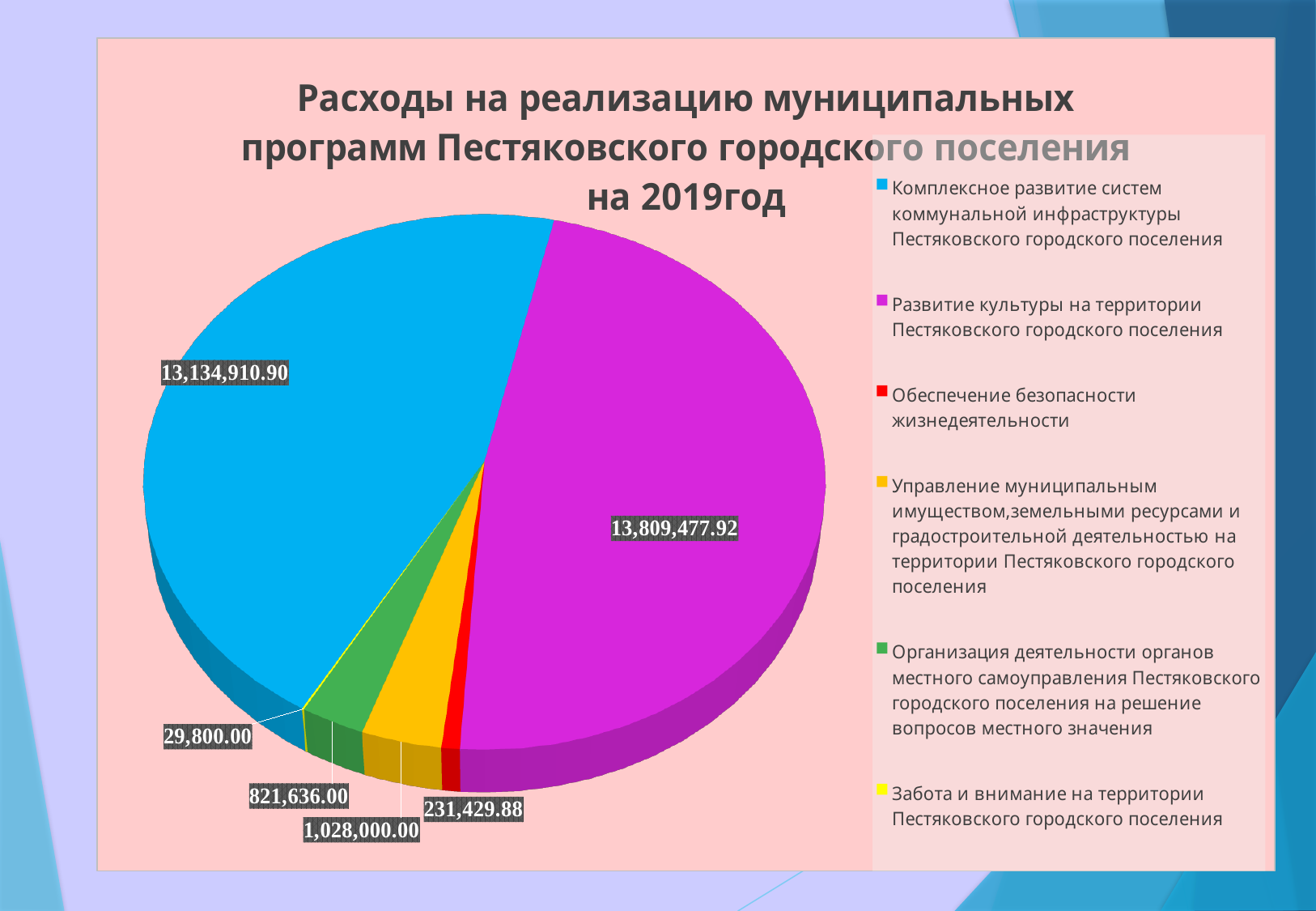
Which program has the smallest expenditure? Забота и внимание на территории Пестяковского городского поселения Which is larger: the value for «Управление муниципальным имуществом...» or for «Организация деятельности органов местного самоуправления...»? Управление муниципальным имуществом... What is the value for «Развитие культуры на территории Пестяковского городского поселения»? 13,809,477.92 What is the value for «Обеспечение безопасности жизнедеятельности»? 231,429.88 How many programs (slices) does the pie chart show? 6 What is the difference between the values for «Развитие культуры» and «Комплексное развитие систем коммунальной инфраструктуры»? 674,567.02 What is the value for «Комплексное развитие систем коммунальной инфраструктуры Пестяковского городского поселения»? 13,134,910.90 What is the value for «Забота и внимание на территории Пестяковского городского поселения»? 29,800.00 Which program has the largest expenditure? Развитие культуры на территории Пестяковского городского поселения What kind of chart is shown on the slide? Pie chart What colour is the slice for «Обеспечение безопасности жизнедеятельности»? Red What is the value for «Организация деятельности органов местного самоуправления Пестяковского городского поселения на решение вопросов местного значения»? 821,636.00